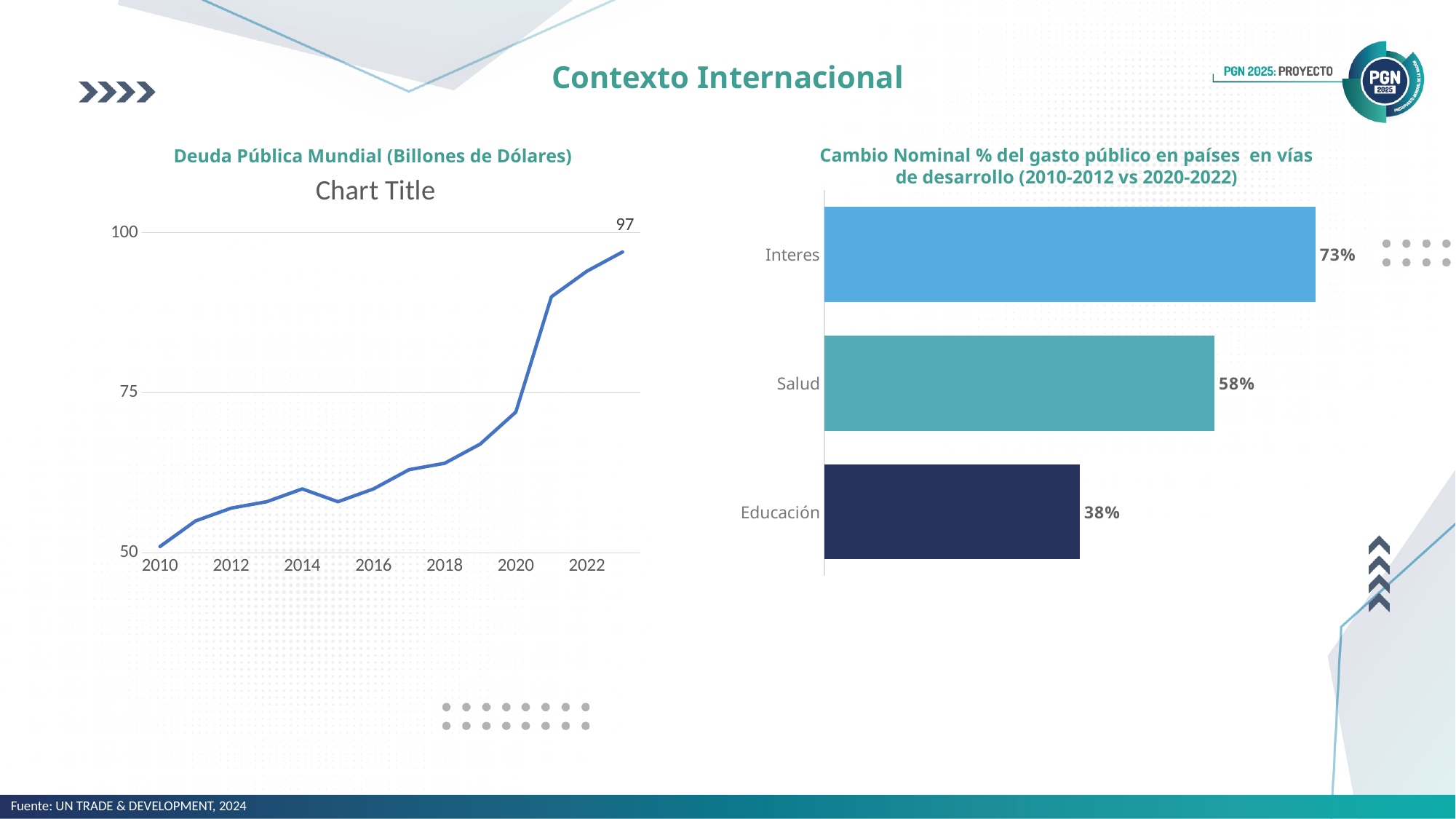
In the chart 'Deuda Pública Mundial (Billones de Dólares)', what is the value labelled at the last data point? 97 In the chart 'Deuda Pública Mundial (Billones de Dólares)', do the values generally rise or fall from 2010 to the end of the series? Rise In the bar chart on the right, which is larger, the value for Salud or the value for Educación? Salud In the chart 'Cambio Nominal % del gasto público en países en vías de desarrollo (2010-2012 vs 2020-2022)', what is the value for Interes? 73% In the chart 'Cambio Nominal % del gasto público en países en vías de desarrollo (2010-2012 vs 2020-2022)', what is the value for Educación? 38% In the bar chart on the right, which category has the lowest value? Educación What kind of chart is 'Deuda Pública Mundial (Billones de Dólares)'? Line chart In the bar chart on the right, what is the difference between the values for Interes and Educación? 35% In the bar chart on the right, which category has the highest value? Interes In the chart 'Cambio Nominal % del gasto público en países en vías de desarrollo (2010-2012 vs 2020-2022)', what is the value for Salud? 58% What kind of chart is the chart on the right of the slide? Bar chart How many categories are shown in the bar chart on the right? 3